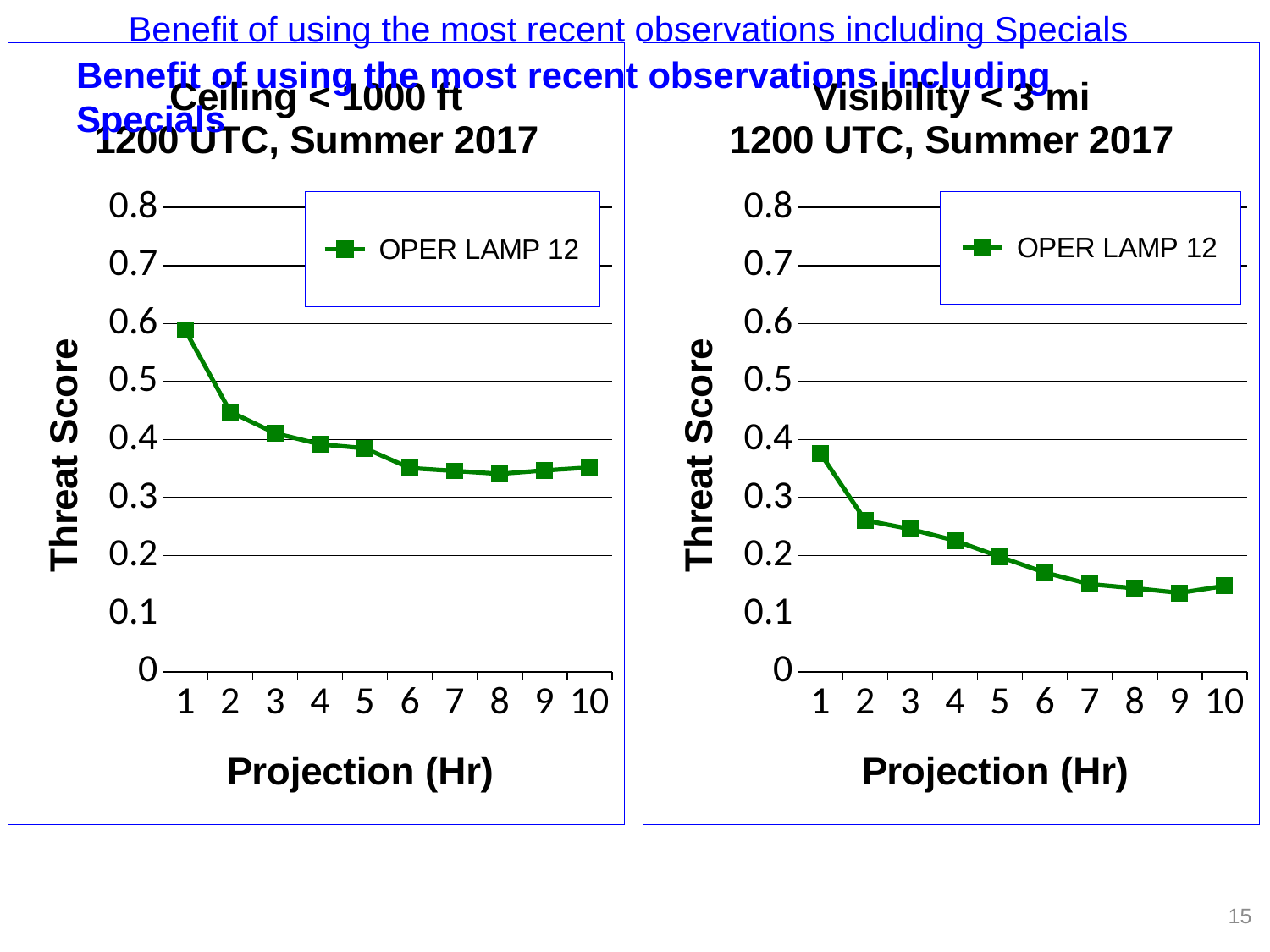
What is the name of the series plotted on the 'Ceiling < 1000 ft' chart on the left? OPER LAMP 12 At projection hour 1, which chart shows the larger threat score: 'Ceiling < 1000 ft' on the left or 'Visibility < 3 mi' on the right? Ceiling < 1000 ft On the 'Ceiling < 1000 ft' chart on the left, is the threat score at projection hour 1 greater or less than 0.5? greater On the 'Ceiling < 1000 ft' chart on the left, does the threat score generally rise or fall as the projection hour increases? fall How many series does the legend list on the 'Visibility < 3 mi' chart on the right? 1 On the 'Ceiling < 1000 ft' chart on the left, at which projection hour is the threat score highest? 1 On the 'Ceiling < 1000 ft' chart on the left, is the threat score at projection hour 8 greater or less than 0.4? less On the 'Visibility < 3 mi' chart on the right, is the threat score at projection hour 9 greater or less than 0.2? less What kind of chart is the 'Ceiling < 1000 ft' chart on the left? line chart On the 'Visibility < 3 mi' chart on the right, at which projection hour is the threat score highest? 1 How many projection hours are plotted on the 'Visibility < 3 mi' chart on the right? 10